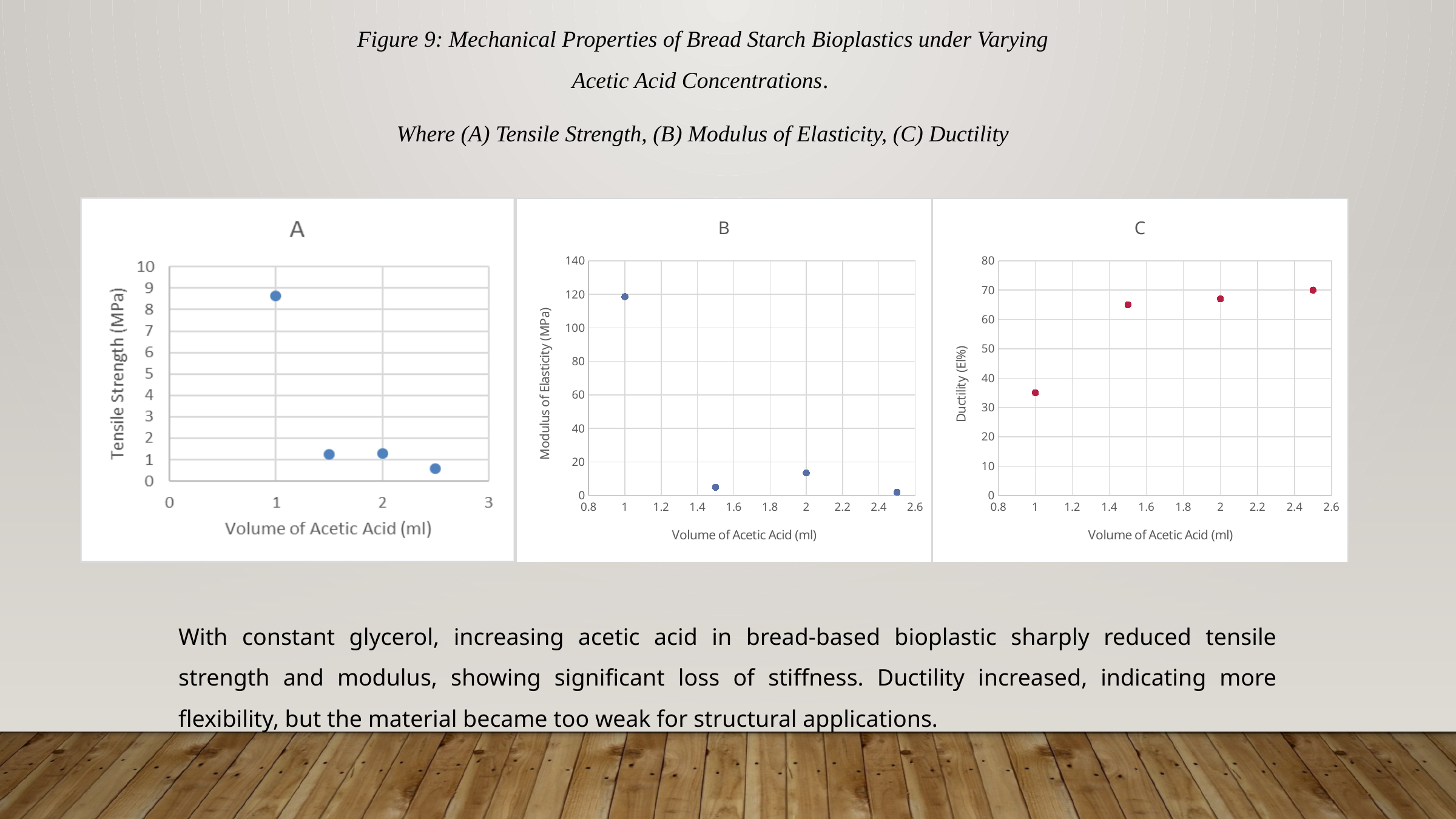
In chart B, is the modulus of elasticity at 1 ml of acetic acid greater or less than 100? greater What is the y-axis label of chart B? Modulus of Elasticity (MPa) In chart B, at which volume of acetic acid is the modulus of elasticity lowest? 2.5 In chart C, is the ductility at 1 ml of acetic acid greater or less than 40? less In chart A, at which volume of acetic acid is the tensile strength highest? 1 In chart B, which has the larger modulus of elasticity: 1.5 ml or 2 ml of acetic acid? 2 ml In chart C, at which volume of acetic acid is the ductility lowest? 1 What kind of chart is chart A? scatter chart In chart A, is the tensile strength at 1 ml of acetic acid greater or less than 8? greater In chart C, does ductility generally rise or fall as the volume of acetic acid increases? rise How many data points are plotted in chart B? 4 In chart A, at which volume of acetic acid is the tensile strength lowest? 2.5